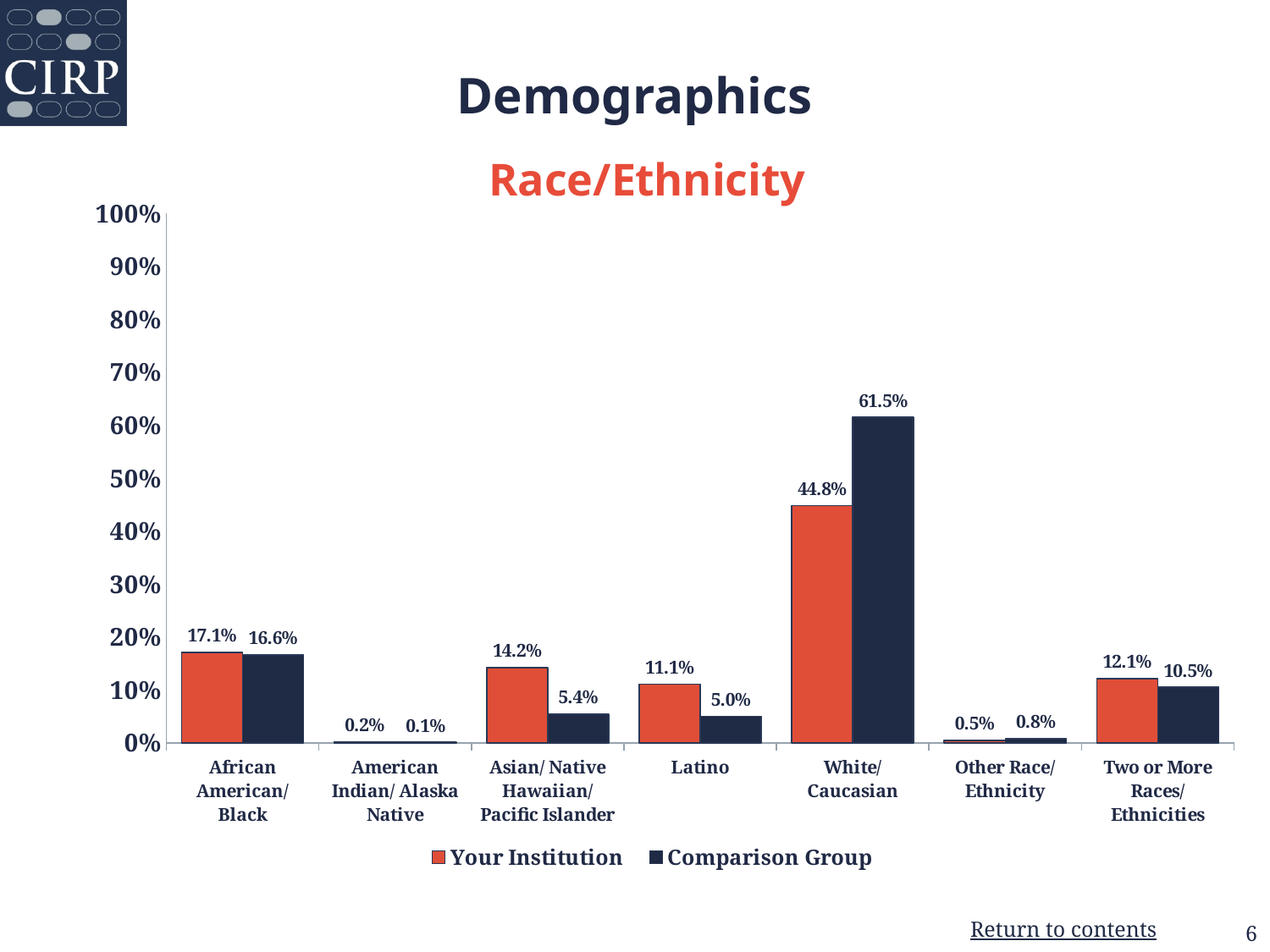
What is the value for Your Institution in the White/Caucasian category? 44.8% Which category has the lowest value for Your Institution? American Indian/Alaska Native What is the difference between the Comparison Group and Your Institution values for White/Caucasian? 16.7% Which category has the highest value for the Comparison Group? White/Caucasian What is the value for Your Institution in the Asian/Native Hawaiian/Pacific Islander category? 14.2% Which is larger for Two or More Races/Ethnicities: Your Institution or the Comparison Group? Your Institution What is the value for the Comparison Group in the Latino category? 5.0% What is the difference between Your Institution and the Comparison Group values for Asian/Native Hawaiian/Pacific Islander? 8.8% Is the Comparison Group value for White/Caucasian greater or less than 60%? greater What kind of chart is shown on the slide? Bar chart How many race/ethnicity categories are shown on the x axis? 7 How many series does the legend list? 2